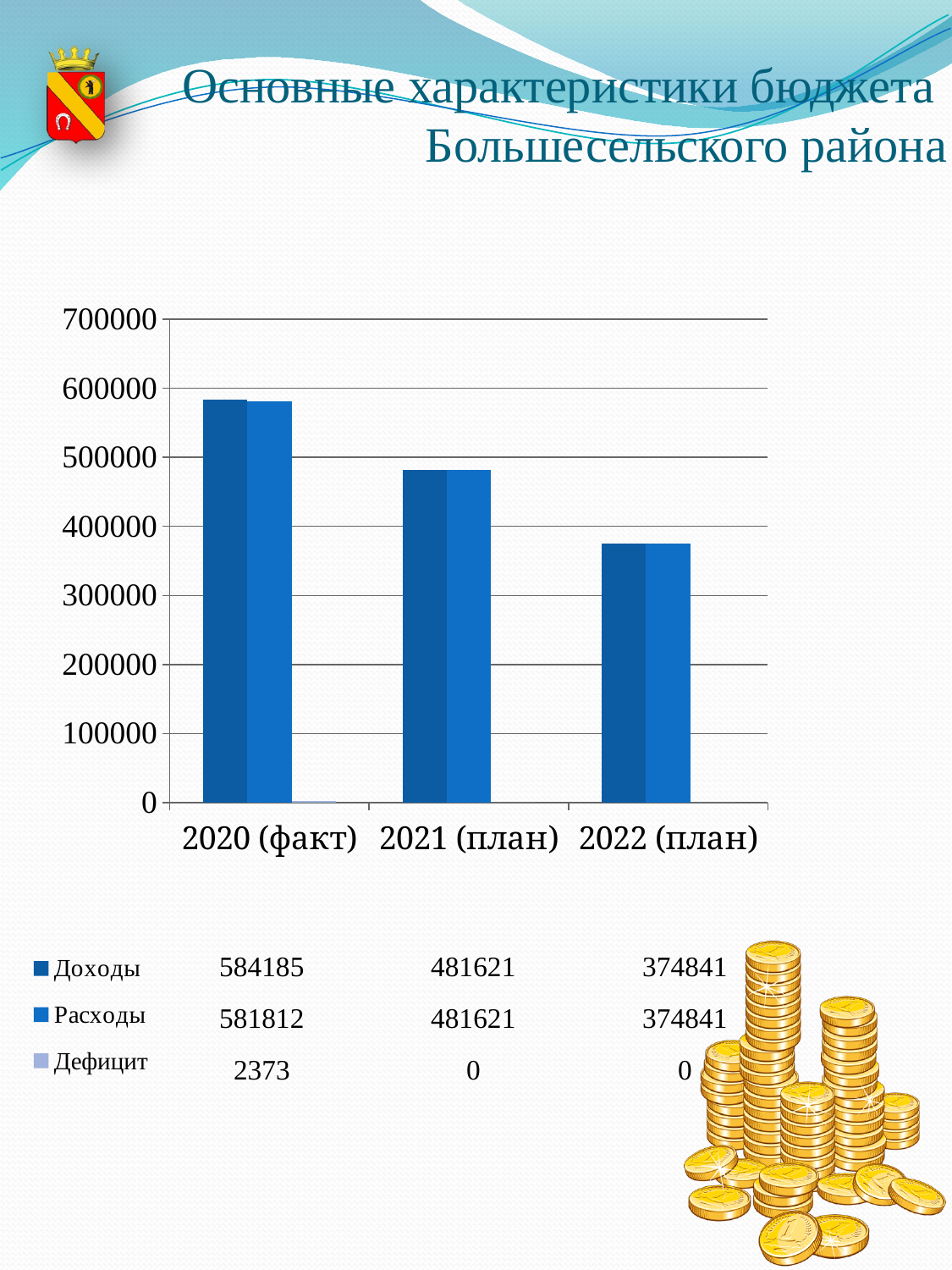
What is the value of Расходы for 2020 (факт)? 581812 What is the difference between Доходы for 2020 (факт) and Доходы for 2021 (план)? 102564 What is the value of Доходы for 2020 (факт)? 584185 What type of chart is shown on the slide? bar chart What is the value of Дефицит for 2021 (план)? 0 What is the value of Дефицит for 2020 (факт)? 2373 How many categories are shown on the x axis? 3 Which category has the lowest value for Расходы? 2022 (план) What is the value of Доходы for 2022 (план)? 374841 Which category has the highest value for Доходы? 2020 (факт) How many series does the legend list? 3 Do the Доходы values rise or fall from 2020 (факт) to 2022 (план)? fall